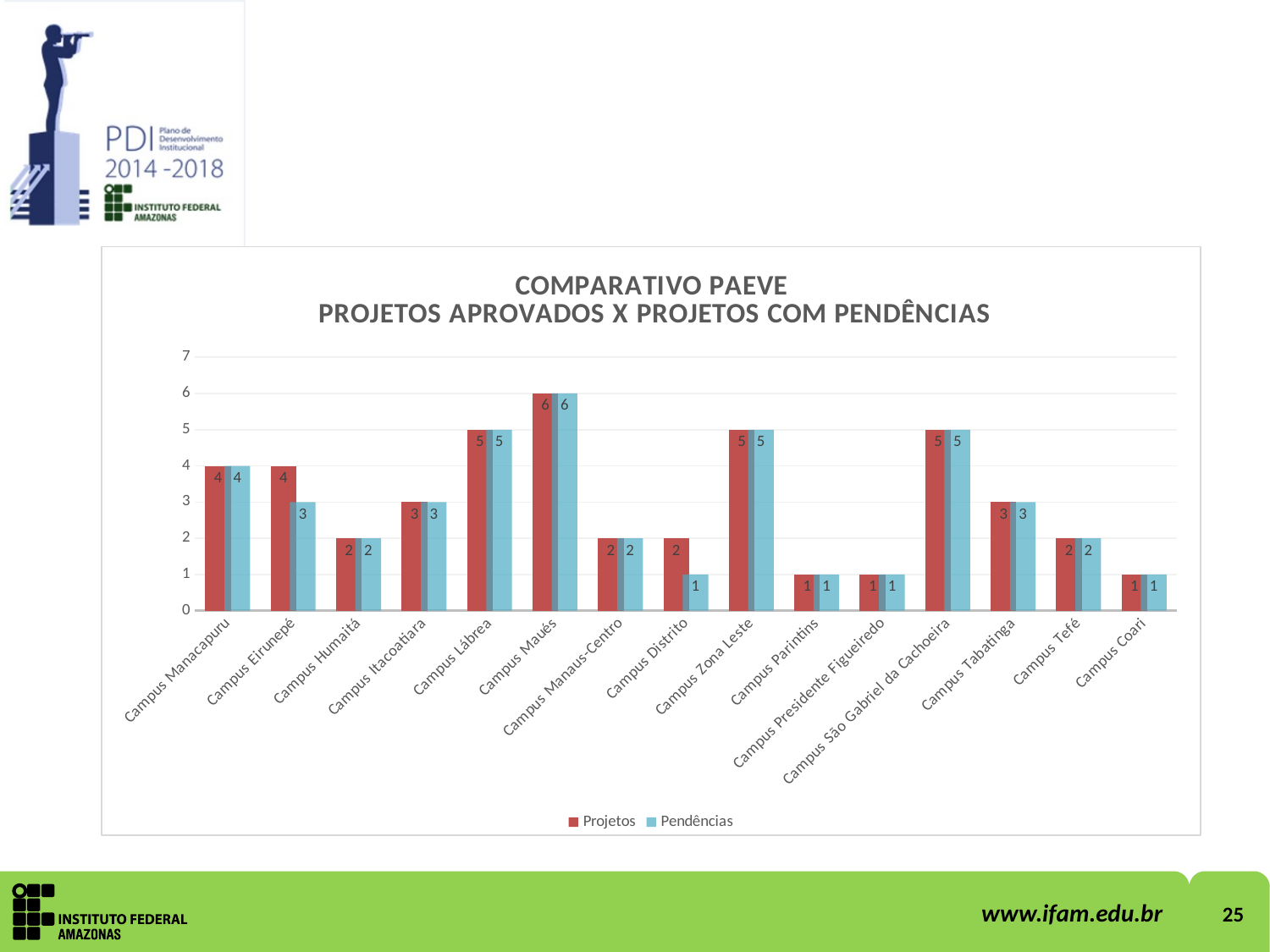
Which has a higher Projetos value, Campus Lábrea or Campus Humaitá? Campus Lábrea What is the difference between the Projetos value for Campus Maués and the Projetos value for Campus Coari? 5 What kind of chart is shown on the slide? Bar chart How many series does the legend list? 2 What is the Projetos value for Campus Eirunepé? 4 What is the difference between the Projetos and Pendências values for Campus Eirunepé? 1 How many campuses are shown on the x axis of the chart? 15 What is the Projetos value for Campus São Gabriel da Cachoeira? 5 Which campus has the highest Projetos value? Campus Maués What is the Pendências value for Campus Eirunepé? 3 What is the Pendências value for Campus Distrito? 1 Which colour represents the Pendências series in the chart? Blue